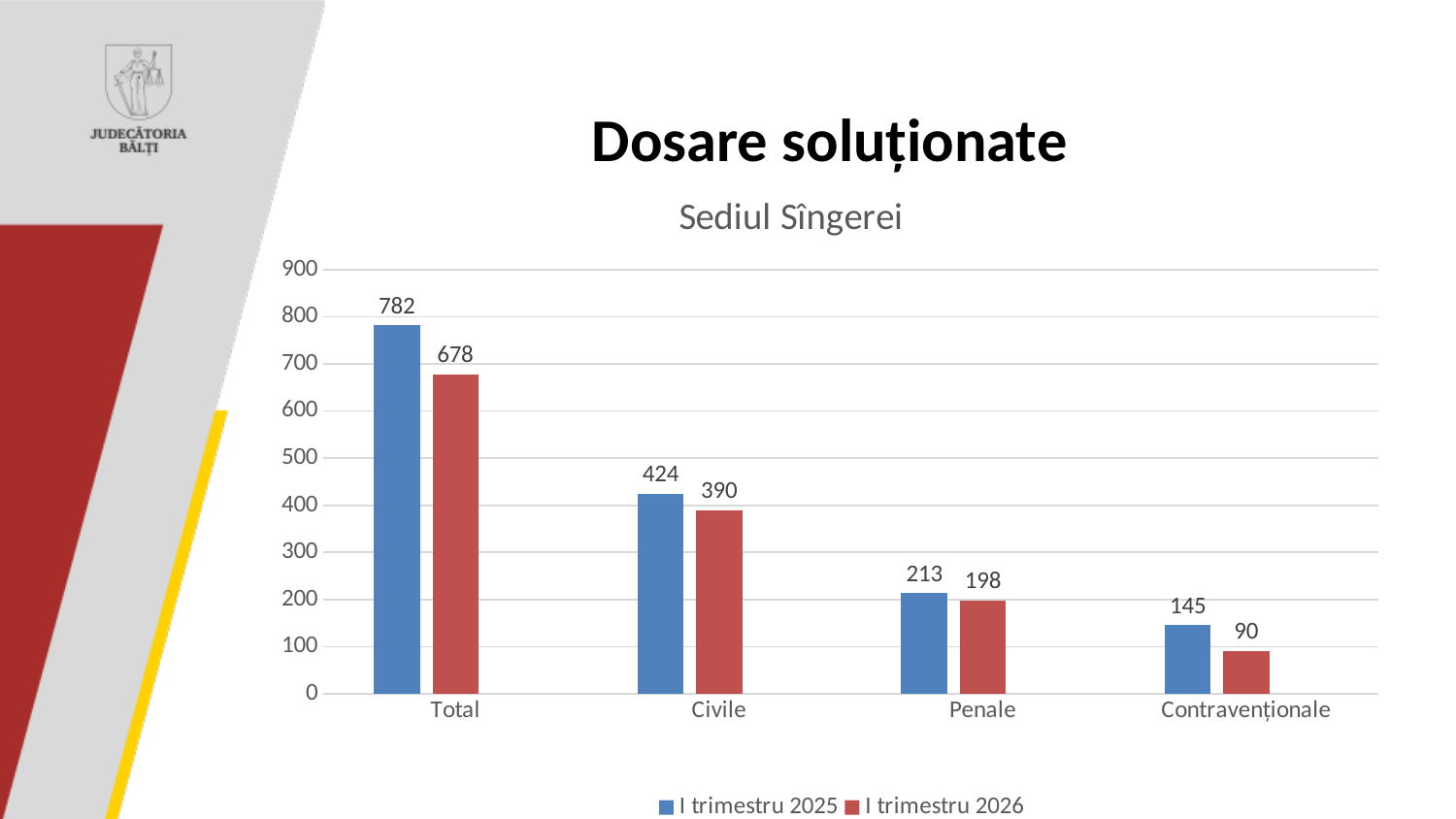
What is the difference between the Total values for I trimestru 2025 and I trimestru 2026? 104 Which category has the lowest value in I trimestru 2026? Contravenționale What is the difference between the Contravenționale values for I trimestru 2025 and I trimestru 2026? 55 How many series does the legend list? 2 What is the value for Contravenționale in I trimestru 2026? 90 How many categories are shown on the x axis? 4 Which is larger: Penale in I trimestru 2025 or Penale in I trimestru 2026? I trimestru 2025 Excluding Total, which category has the highest value in I trimestru 2025? Civile What is the value for Civile in I trimestru 2026? 390 What is the value for Penale in I trimestru 2025? 213 What kind of chart is shown on the slide? Bar chart What is the value for Total in I trimestru 2025? 782